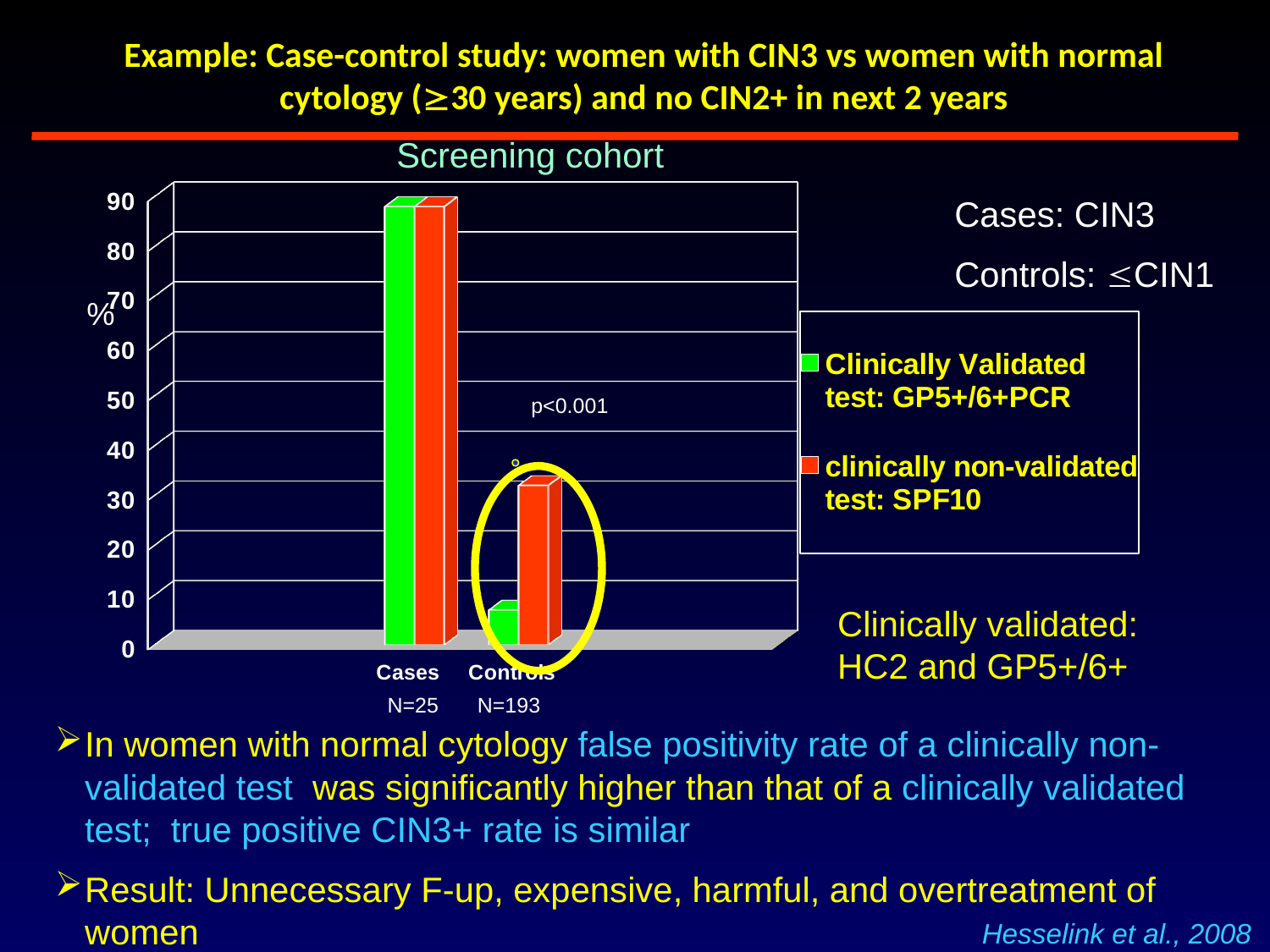
What kind of chart is shown on the slide? bar chart What is the title of the chart? Screening cohort Is the value for the clinically non-validated test (SPF10) in the Controls group greater or less than 40? less Is the value for the clinically validated test (GP5+/6+PCR) in the Controls group greater or less than 20? less How many categories are shown on the x axis of the chart? 2 In which category does the clinically validated test (GP5+/6+PCR) have its lowest value? Controls Is the value for the clinically non-validated test (SPF10) in the Controls group greater or less than 20? greater In which category does the clinically non-validated test (SPF10) have its highest value? Cases For the Controls group, which test has the higher value: the clinically validated test (GP5+/6+PCR) or the clinically non-validated test (SPF10)? clinically non-validated test: SPF10 Which colour represents the clinically validated test (GP5+/6+PCR) in the chart? green How many series does the chart legend list? 2